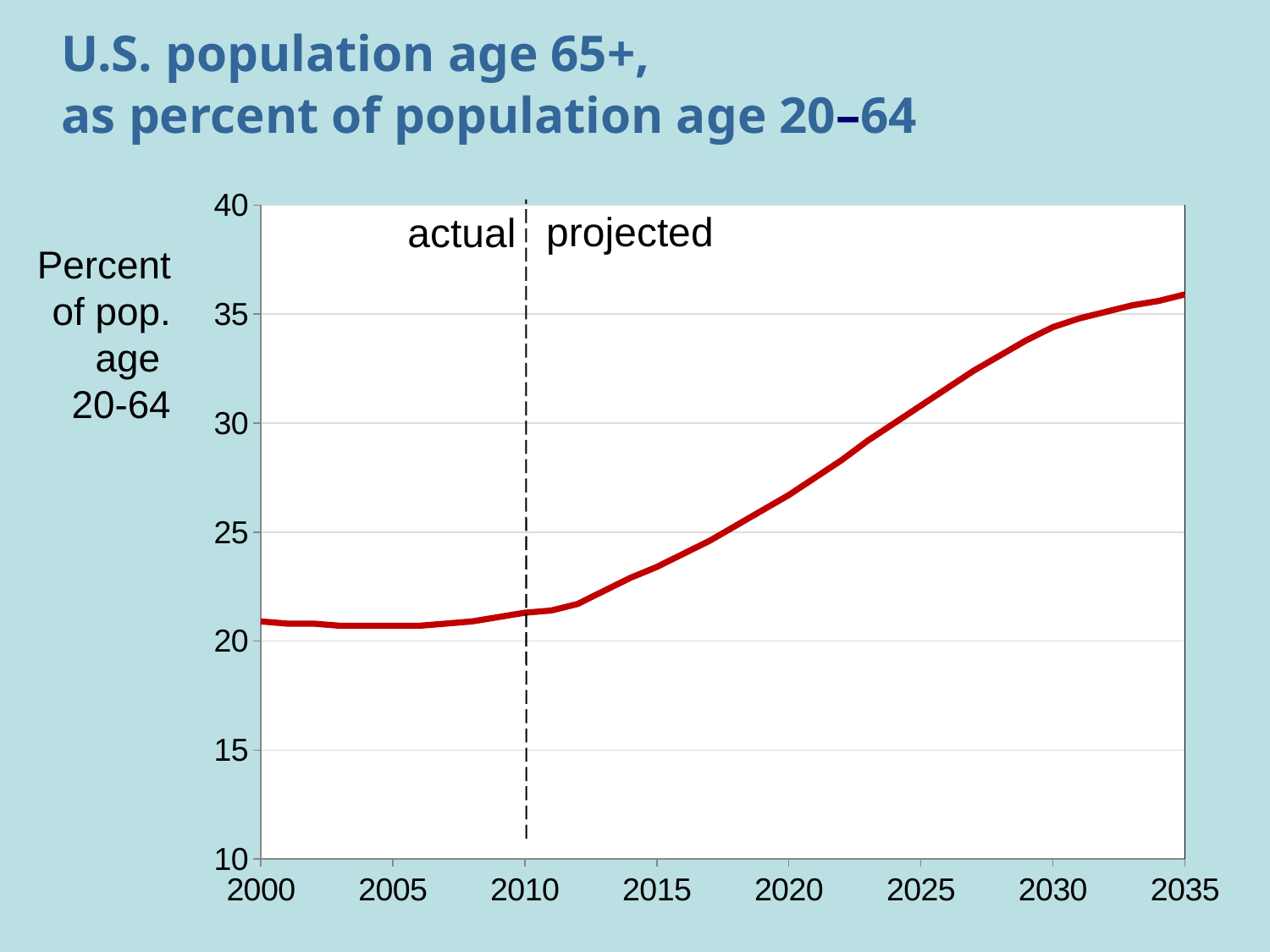
Is the value for 2035 greater or less than 35? greater Is the value for 2020 greater or less than 25? greater What kind of chart is shown on the slide? line chart Is the value for 2000 greater or less than 25? less At which year does the dashed line separating 'actual' from 'projected' fall? 2010 Do the values rise or fall along the x axis from 2010 to 2035? rise Which year has the larger value, 2000 or 2035? 2035 What is the title of the chart? U.S. population age 65+, as percent of population age 20–64 Which year shown on the x axis has the highest value? 2035